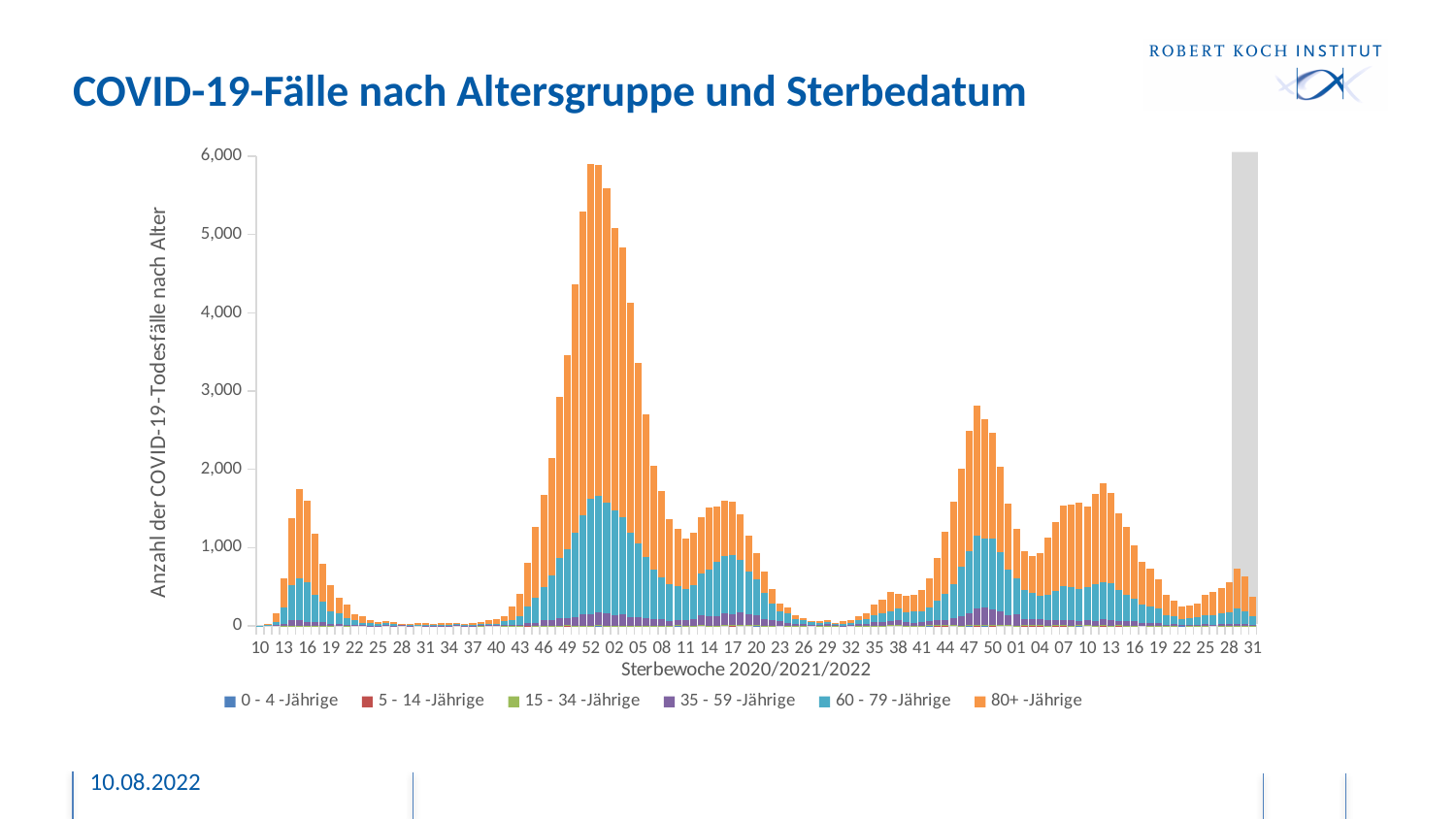
What is the title of the chart? COVID-19-Fälle nach Altersgruppe und Sterbedatum What kind of chart is shown on the slide? bar chart Is the value of the bar at the first x-axis label 16 greater or less than 1,000? greater Is the value of the tallest bar greater or less than 5,000? greater Between the x-axis labels 52 and 08, do the bar heights rise or fall? fall Is the value of the bar at the first x-axis label 28 greater or less than 1,000? less Between the x-axis labels 43 and 52, do the bar heights rise or fall? rise How many series does the legend list? 6 Which age group is shown in orange in the legend? 80+ -Jährige In the tallest bars, which age group contributes more: 80+ -Jährige or 60 - 79 -Jährige? 80+ -Jährige